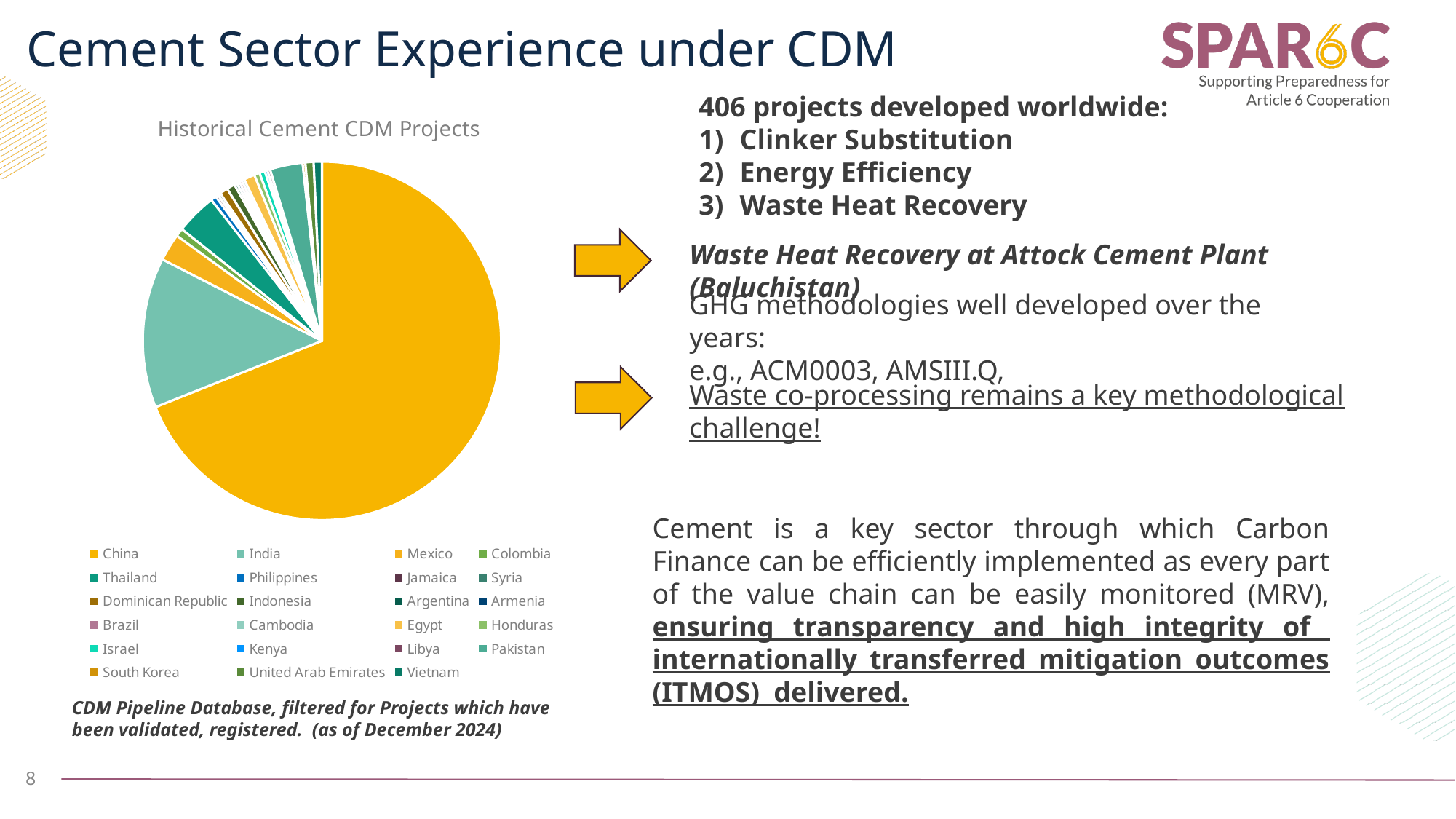
In the 'Historical Cement CDM Projects' pie chart, which slice is larger, Thailand or Mexico? Thailand What colour is the China slice in the 'Historical Cement CDM Projects' pie chart? yellow In the 'Historical Cement CDM Projects' pie chart, which slice is larger, India or Mexico? India What kind of chart is the 'Historical Cement CDM Projects' chart? pie chart Which country has the largest slice in the 'Historical Cement CDM Projects' pie chart? China In the 'Historical Cement CDM Projects' pie chart, which slice is larger, China or India? China Does China's slice in the 'Historical Cement CDM Projects' pie chart account for more or less than half of the pie? more How many countries are listed in the legend of the 'Historical Cement CDM Projects' pie chart? 23 Which country has the second-largest slice in the 'Historical Cement CDM Projects' pie chart? India What is the title of the pie chart on the slide? Historical Cement CDM Projects